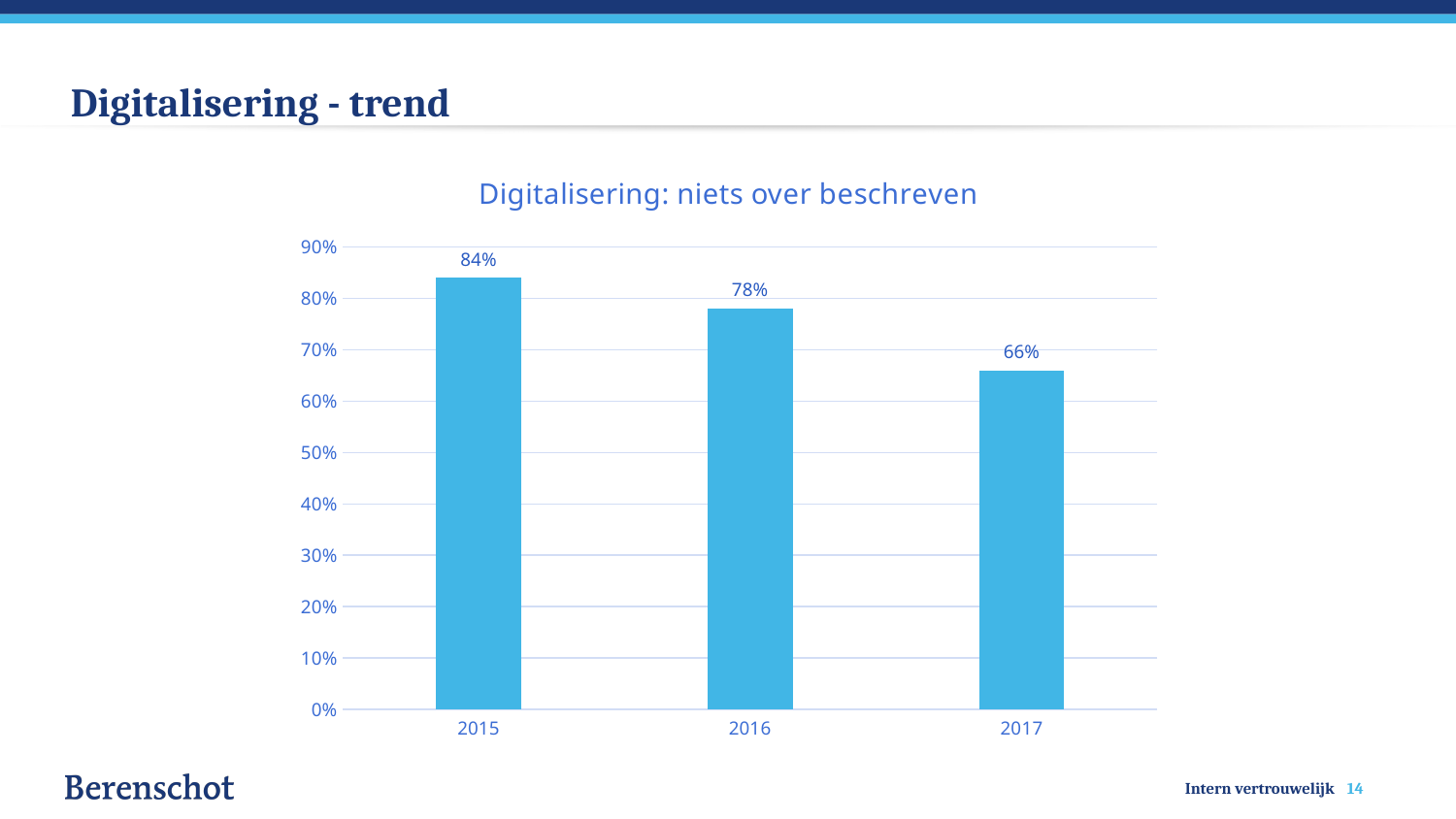
What is the difference between the values for 2016 and 2017? 12% What is the value for 2015? 84% What is the value for 2017? 66% Which year has the highest value? 2015 How many years are shown on the x axis? 3 Which is larger, the value for 2015 or the value for 2016? 2015 What is the value for 2016? 78% What is the difference between the values for 2015 and 2017? 18% What kind of chart is shown on the slide? bar chart Do the values rise or fall from 2015 to 2017? fall Which year has the lowest value? 2017 Is the value for 2017 greater or less than 70%? less